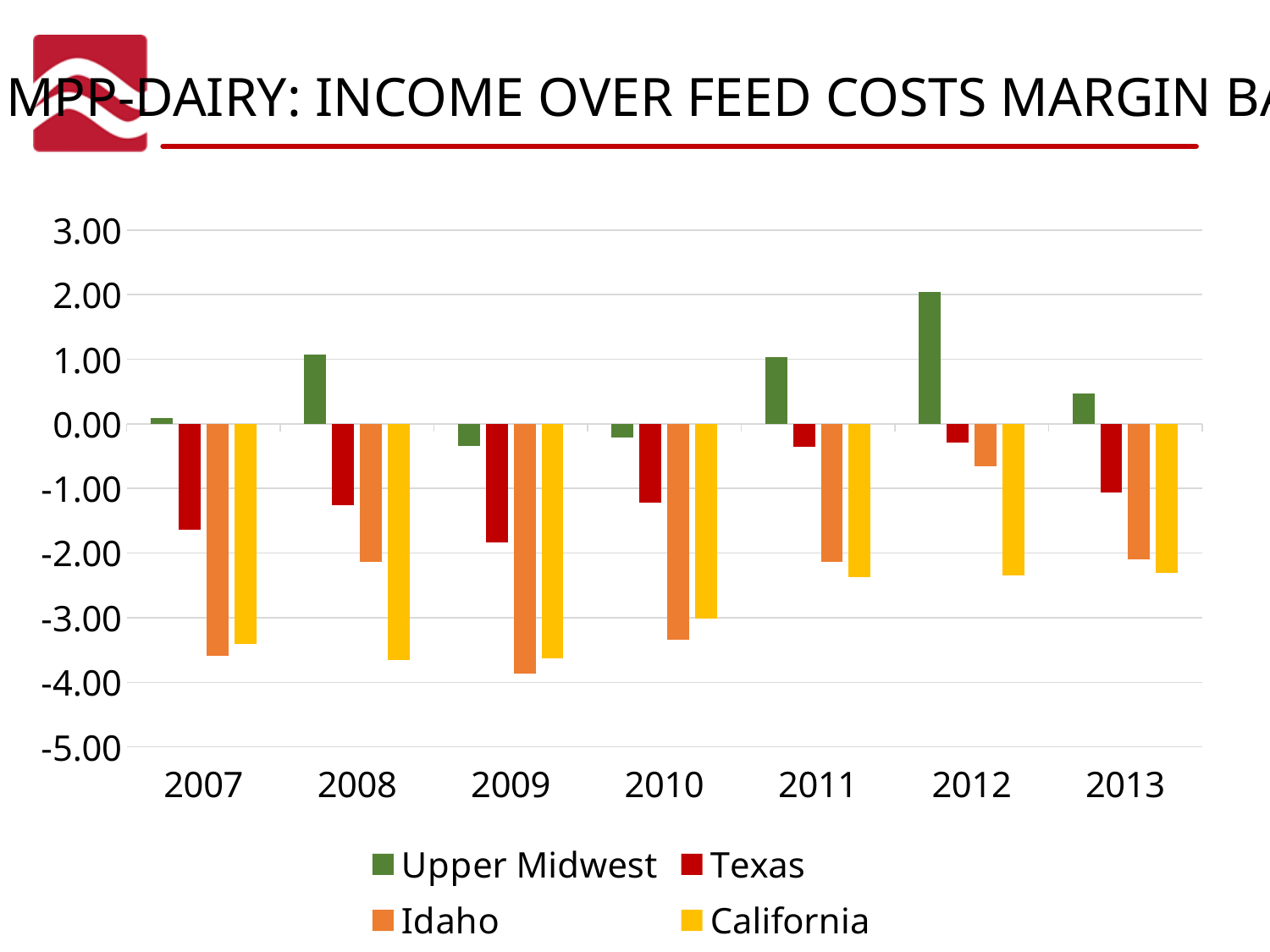
How many years are shown on the x axis? 7 In 2008, which is larger, the Idaho value or the California value? Idaho What kind of chart is shown on the slide? bar chart Is the value for Idaho in 2009 greater or less than -3.00? less Which colour represents California in the legend? yellow How many series does the legend list? 4 Is the value for Upper Midwest in 2012 greater or less than 1.00? greater In 2012, which is larger, the Texas value or the Idaho value? Texas Is the value for California in 2011 greater or less than -3.00? greater In which year is the Upper Midwest value highest? 2012 In which year is the Idaho value lowest? 2009